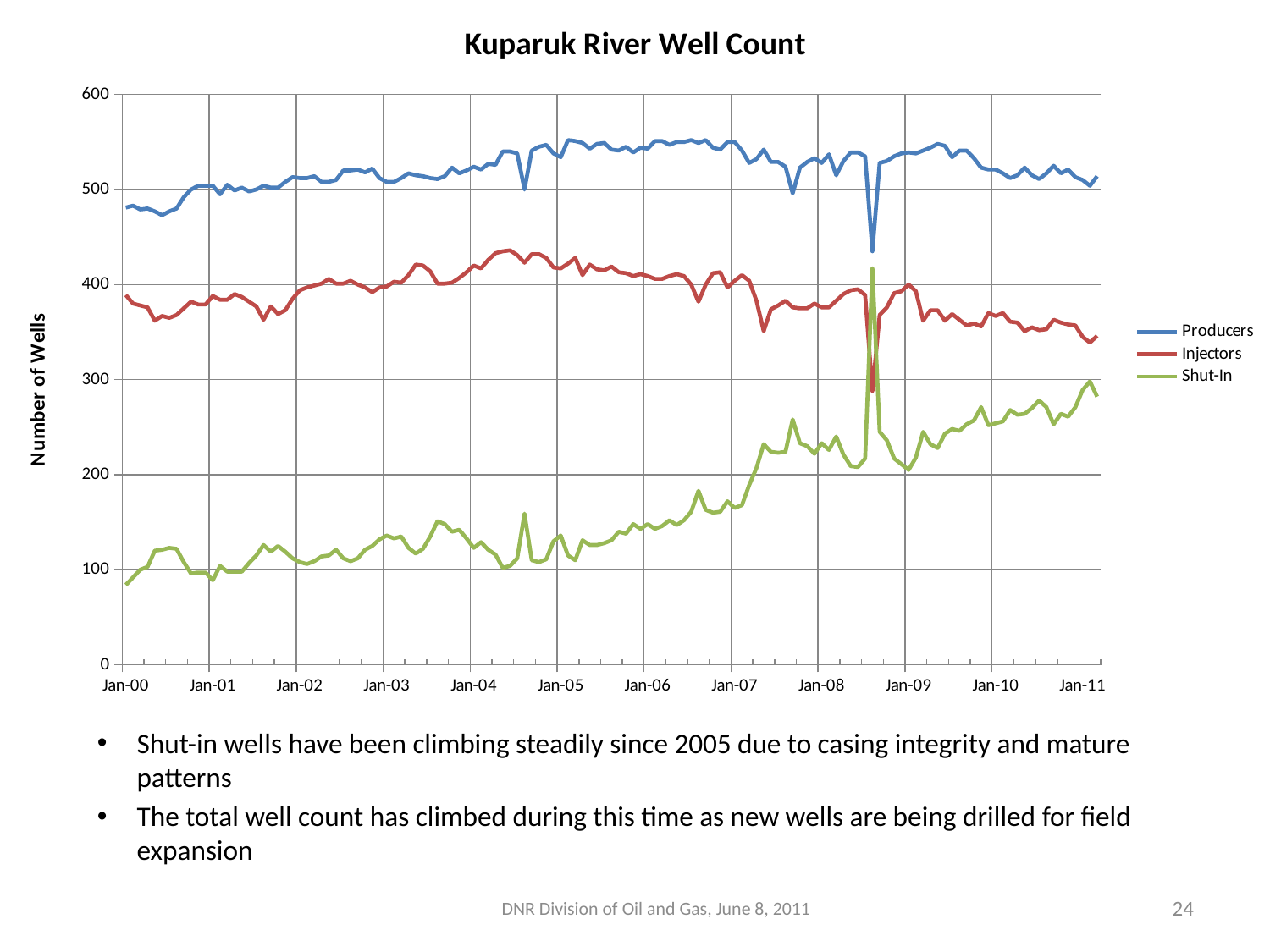
Is the value for Injectors at Jan-11 greater or less than 400? less Is the value for Shut-In at Jan-11 greater or less than 200? greater How many series does the legend list? 3 What kind of chart is shown on the slide? line chart Which series has the highest values throughout the chart? Producers What is the title of the chart? Kuparuk River Well Count Do the Shut-In values rise or fall between Jan-05 and Jan-11? rise Is the value for Producers at Jan-00 greater or less than 500? less What is the label on the vertical axis? Number of Wells At Jan-10, which is larger, Injectors or Shut-In? Injectors